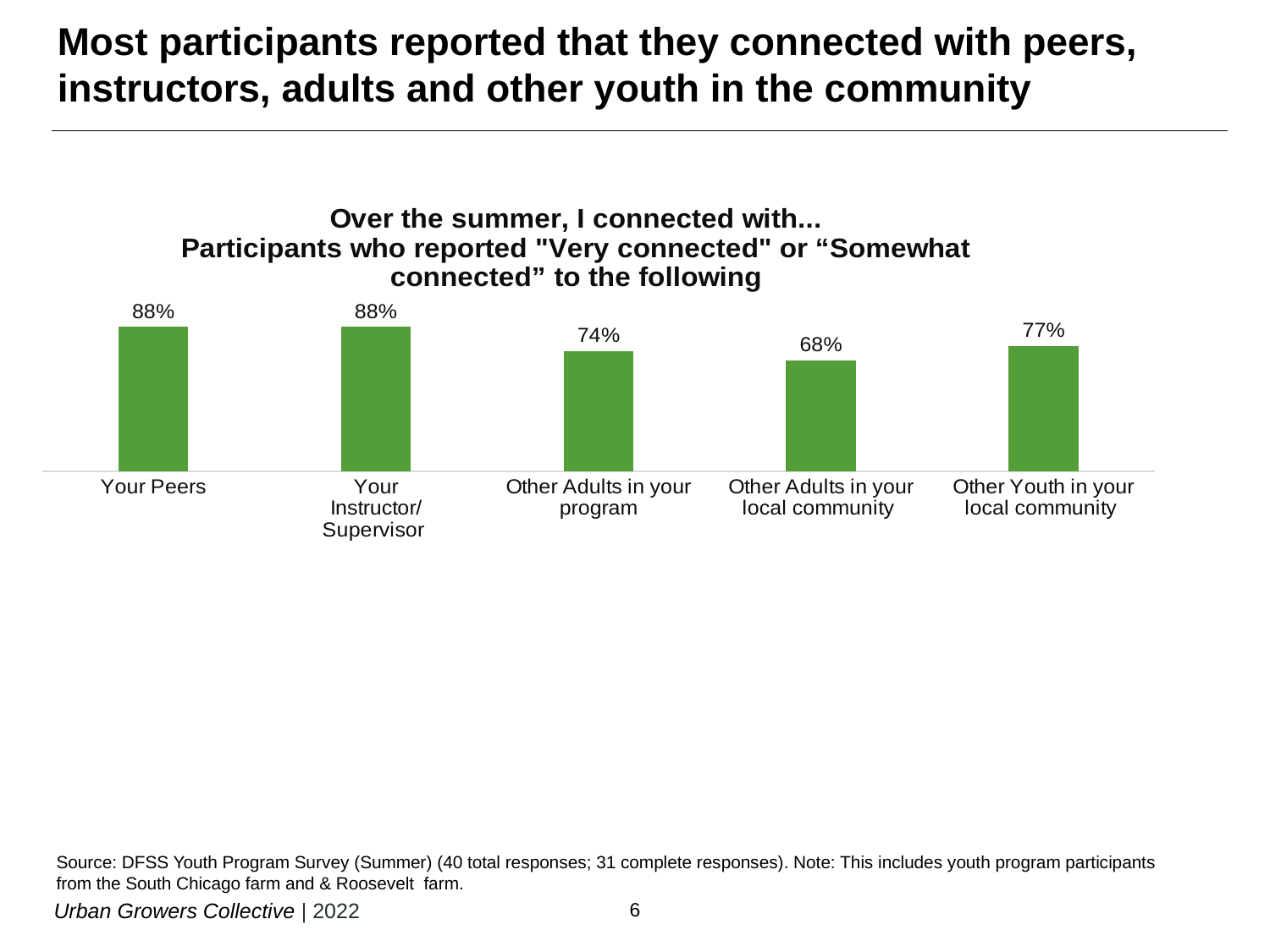
What kind of chart is shown on the slide? Bar chart What is the difference between the values for Your Peers and Other Adults in your local community? 20% Which is larger: the value for Other Adults in your program or Other Youth in your local community? Other Youth in your local community Which category has the lowest value? Other Adults in your local community What is the difference between Other Youth in your local community and Other Adults in your program? 3% Which two categories share the highest value of 88%? Your Peers and Your Instructor/Supervisor What is the value for Other Youth in your local community? 77% What colour are the bars in the chart? Green What is the value for Other Adults in your local community? 68% How many categories are shown in the chart? 5 What percentage of participants reported connecting with Your Peers? 88% What is the value for Other Adults in your program? 74%